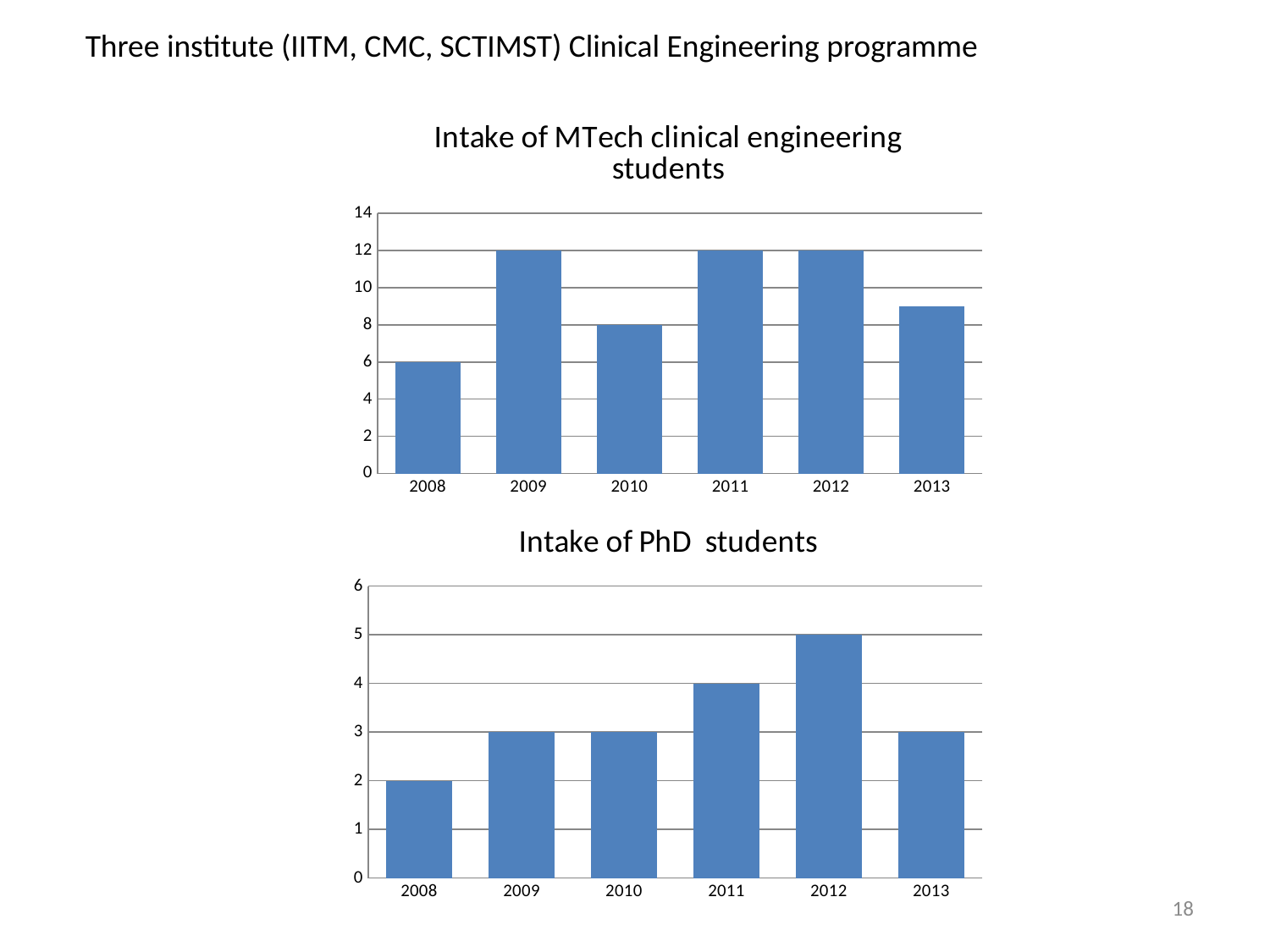
In the 'Intake of MTech clinical engineering students' chart, which year has the lowest intake? 2008 In the 'Intake of MTech clinical engineering students' chart, what is the value for 2009? 12 In the 'Intake of PhD students' chart, what is the value for 2011? 4 In the 'Intake of MTech clinical engineering students' chart, what is the difference between the values for 2009 and 2008? 6 In the 'Intake of MTech clinical engineering students' chart, what is the value for 2010? 8 What type of chart is the 'Intake of PhD students' chart? bar chart In the 'Intake of PhD students' chart, what is the value for 2012? 5 In the 'Intake of MTech clinical engineering students' chart, how many years are shown on the x axis? 6 In the 'Intake of PhD students' chart, which is larger, the value for 2011 or the value for 2013? 2011 In the 'Intake of PhD students' chart, which year has the highest intake? 2012 In the 'Intake of MTech clinical engineering students' chart, is the value for 2013 greater or less than 10? less In the 'Intake of PhD students' chart, which year has the lowest intake? 2008